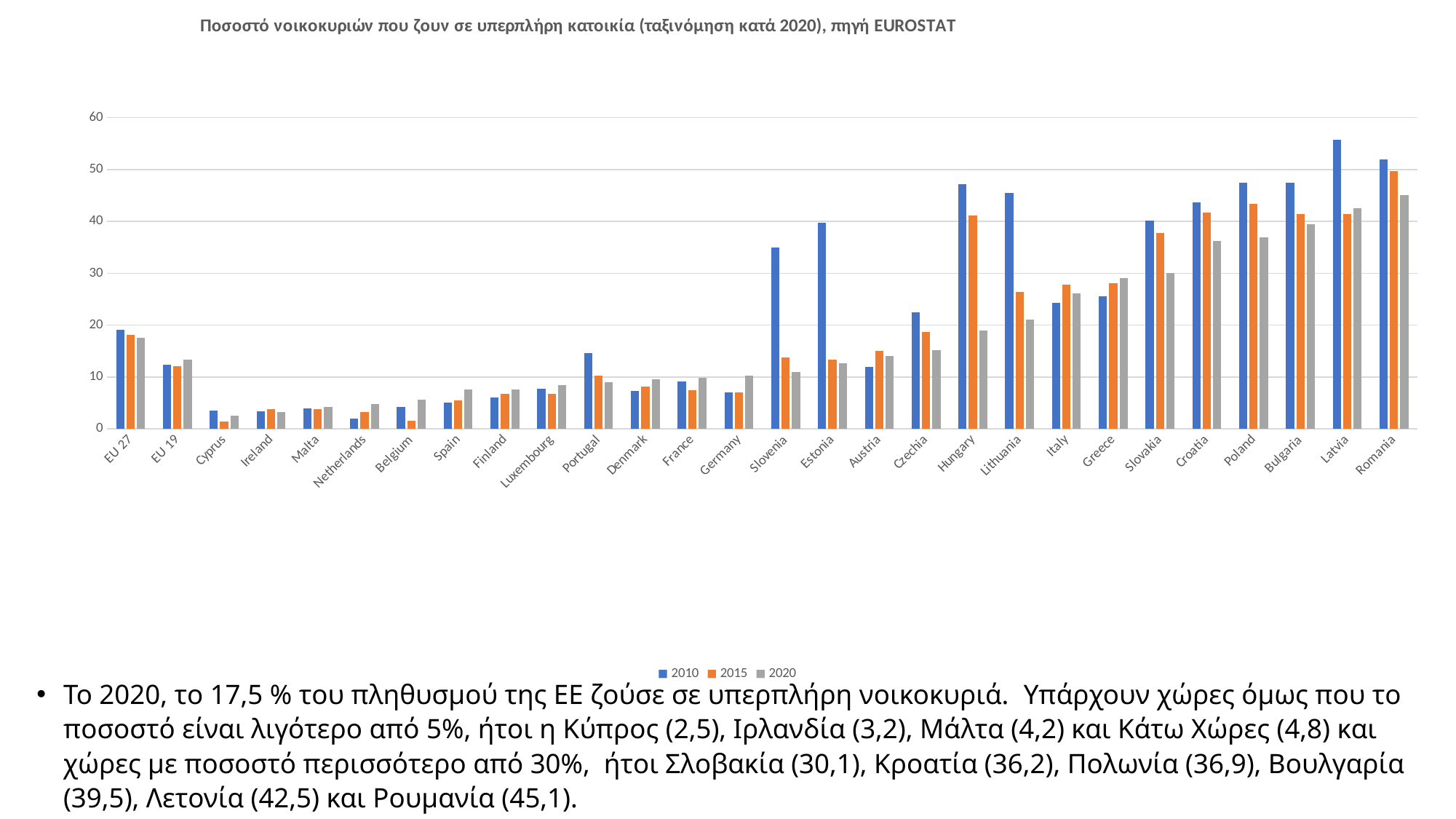
Which category has the highest value for the 2020 series? Romania Which category has the highest value for the 2010 series? Latvia Is the 2010 value for Hungary greater or less than 40? greater How many series does the legend list? 3 How many countries/categories are shown on the x axis? 28 For Hungary, which is larger: the 2010 value or the 2020 value? 2010 Do the 2020 values generally rise or fall moving from left to right along the x axis? Rise Is the 2010 value for Slovenia greater or less than 30? greater What kind of chart is shown on the slide? Bar chart Which category has the lowest value for the 2020 series? Cyprus Is the 2020 value for Estonia greater or less than 20? less Which colour represents the 2015 series in the legend? Orange